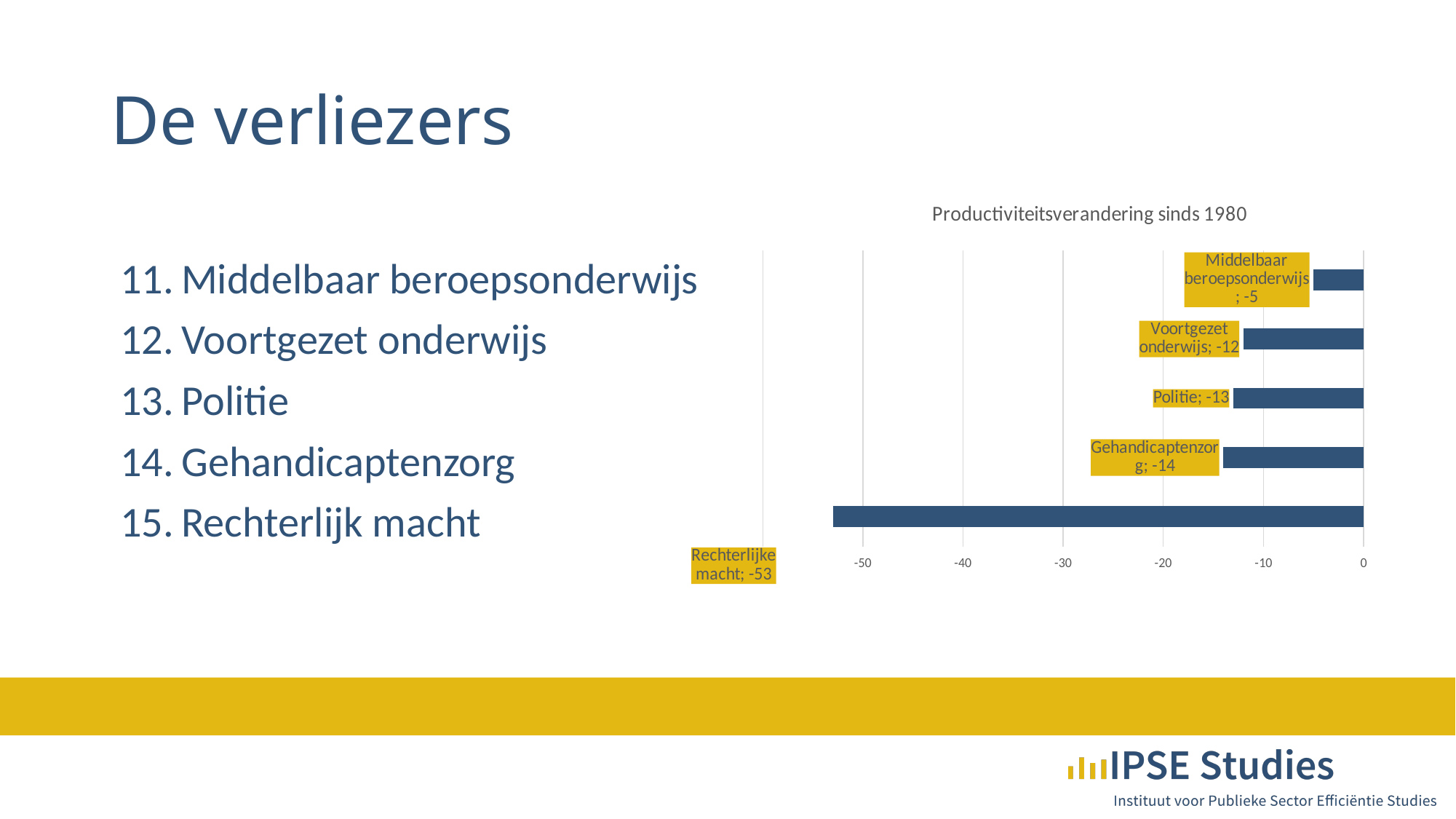
What is the difference between the values for Voortgezet onderwijs and Rechterlijke macht? 41 Which category has the lowest value in the chart? Rechterlijke macht Which has the larger value, Voortgezet onderwijs or Gehandicaptenzorg? Voortgezet onderwijs What is the value for Gehandicaptenzorg in the chart? -14 Is the value for Rechterlijke macht greater or less than -50? less What is the title of the chart? Productiviteitsverandering sinds 1980 What is the value for Rechterlijke macht in the chart? -53 How many categories are shown in the chart? 5 Which category has the highest value in the chart? Middelbaar beroepsonderwijs What kind of chart is shown on the slide? Bar chart What is the value for Middelbaar beroepsonderwijs in the chart? -5 What is the value for Politie in the chart? -13